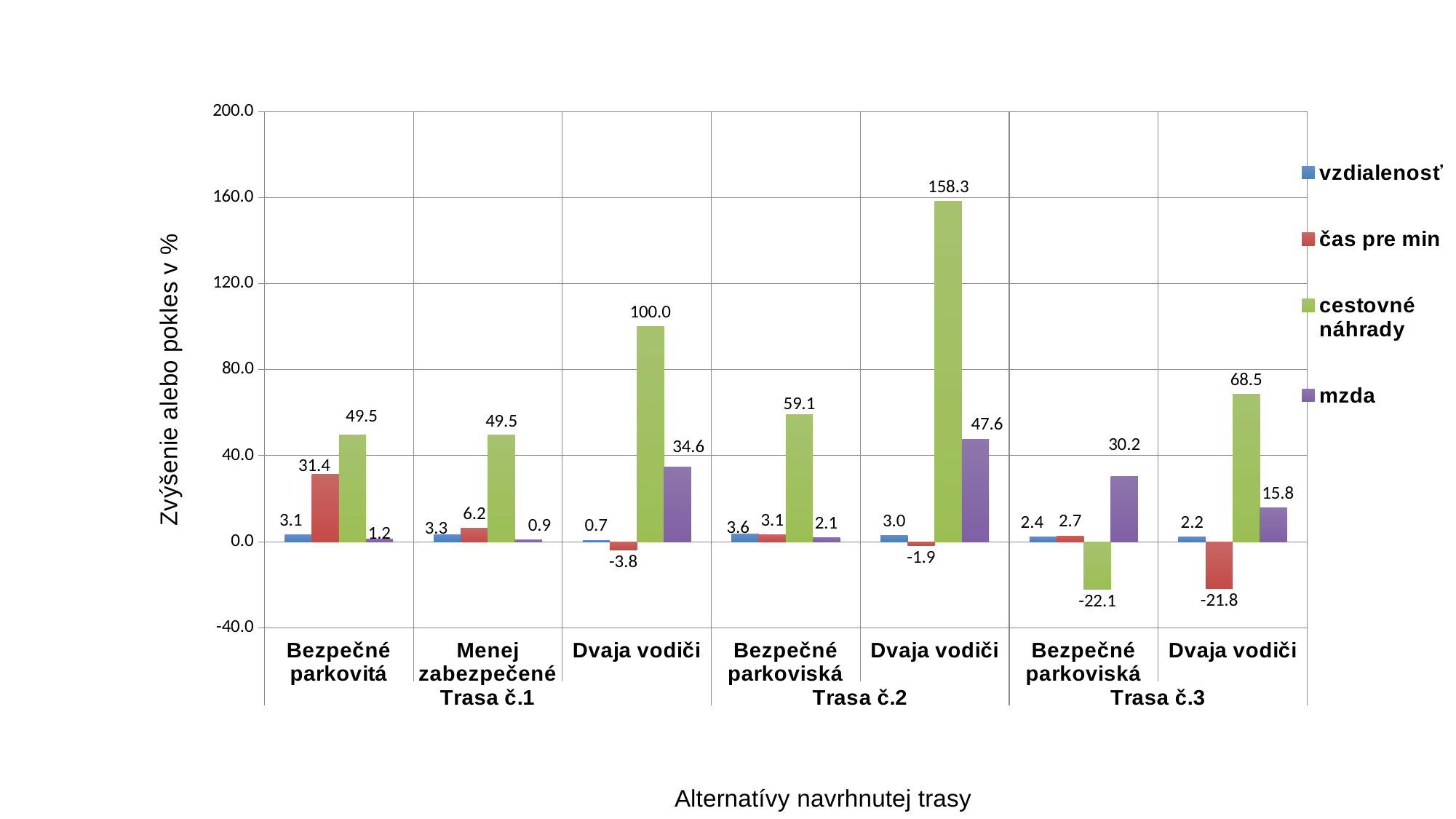
How many series does the legend list? 4 What is the label of the y axis? Zvýšenie alebo pokles v % What is the difference between the cestovné náhrady values for Dvaja vodiči in Trasa č.2 and Dvaja vodiči in Trasa č.1? 58.3 What is the value of cestovné náhrady for Dvaja vodiči in Trasa č.2? 158.3 What is the value of mzda for Dvaja vodiči in Trasa č.3? 15.8 How many category groups are shown along the x axis? 7 What is the value of čas pre min for Bezpečné parkovitá in Trasa č.1? 31.4 What is the value of cestovné náhrady for Bezpečné parkoviská in Trasa č.3? -22.1 Which category has the lowest čas pre min value? Dvaja vodiči (Trasa č.3) What type of chart is shown on the slide? bar chart Which is larger: the mzda value for Dvaja vodiči in Trasa č.1 or the mzda value for Bezpečné parkoviská in Trasa č.3? Dvaja vodiči in Trasa č.1 Which category has the highest cestovné náhrady value? Dvaja vodiči (Trasa č.2)